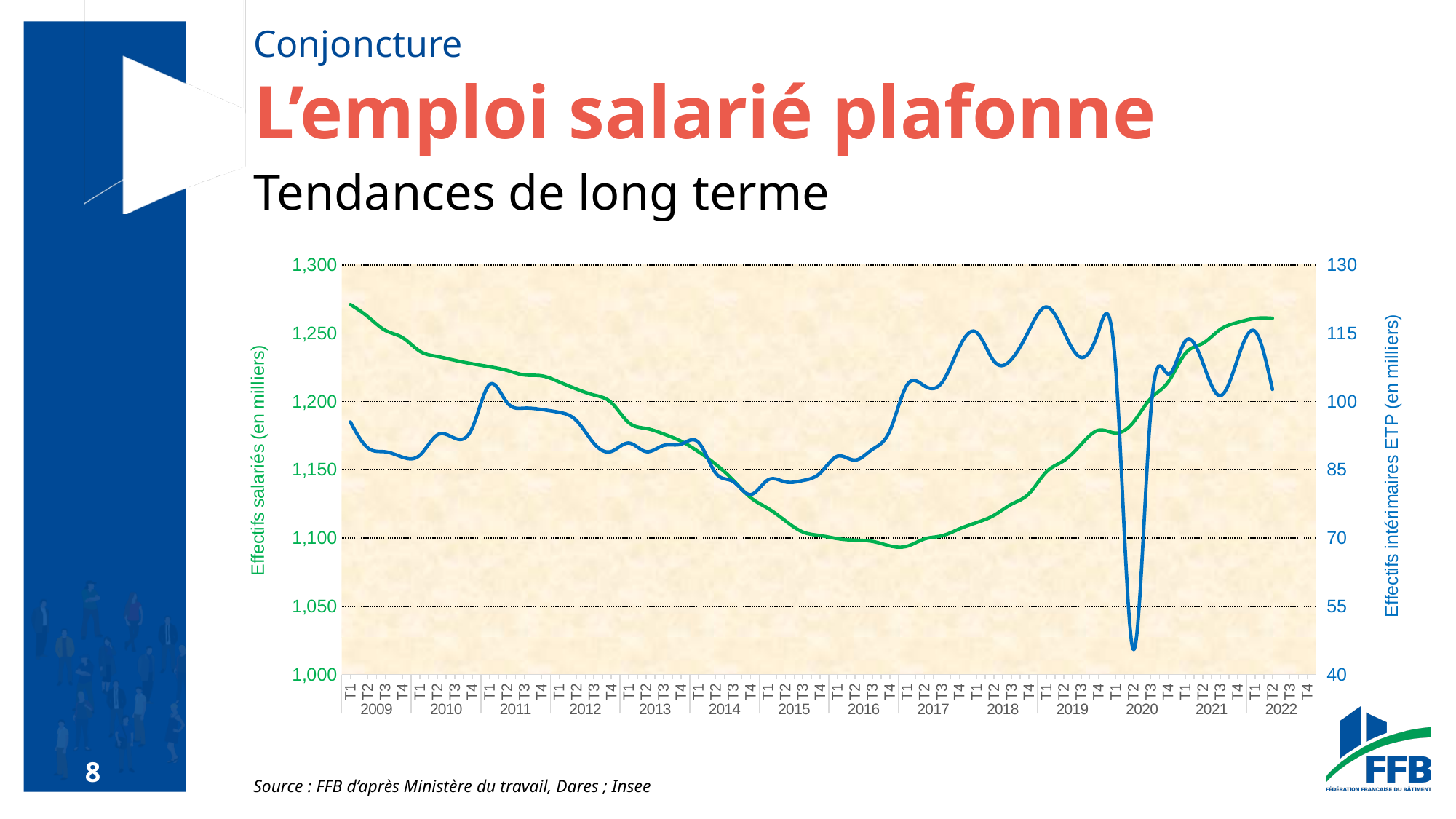
Does the Effectifs salariés series rise or fall between T1 2009 and T1 2017? fall Is the value of Effectifs salariés at T1 2017 greater or less than 1,100? less How many years are labelled along the x axis of the chart? 14 In which quarter does the Effectifs intérimaires ETP series reach its lowest value? T2 2020 Does the Effectifs salariés series rise or fall between T1 2017 and T2 2022? rise Is the value of Effectifs intérimaires ETP at T2 2020 greater or less than 55? less What kind of chart is shown on the slide? line chart How many data series are plotted on the chart? 2 Which series is plotted in green on the chart? Effectifs salariés (en milliers) Which series is plotted in blue on the chart? Effectifs intérimaires ETP (en milliers) Is the value of Effectifs intérimaires ETP at T1 2019 greater or less than 115? greater